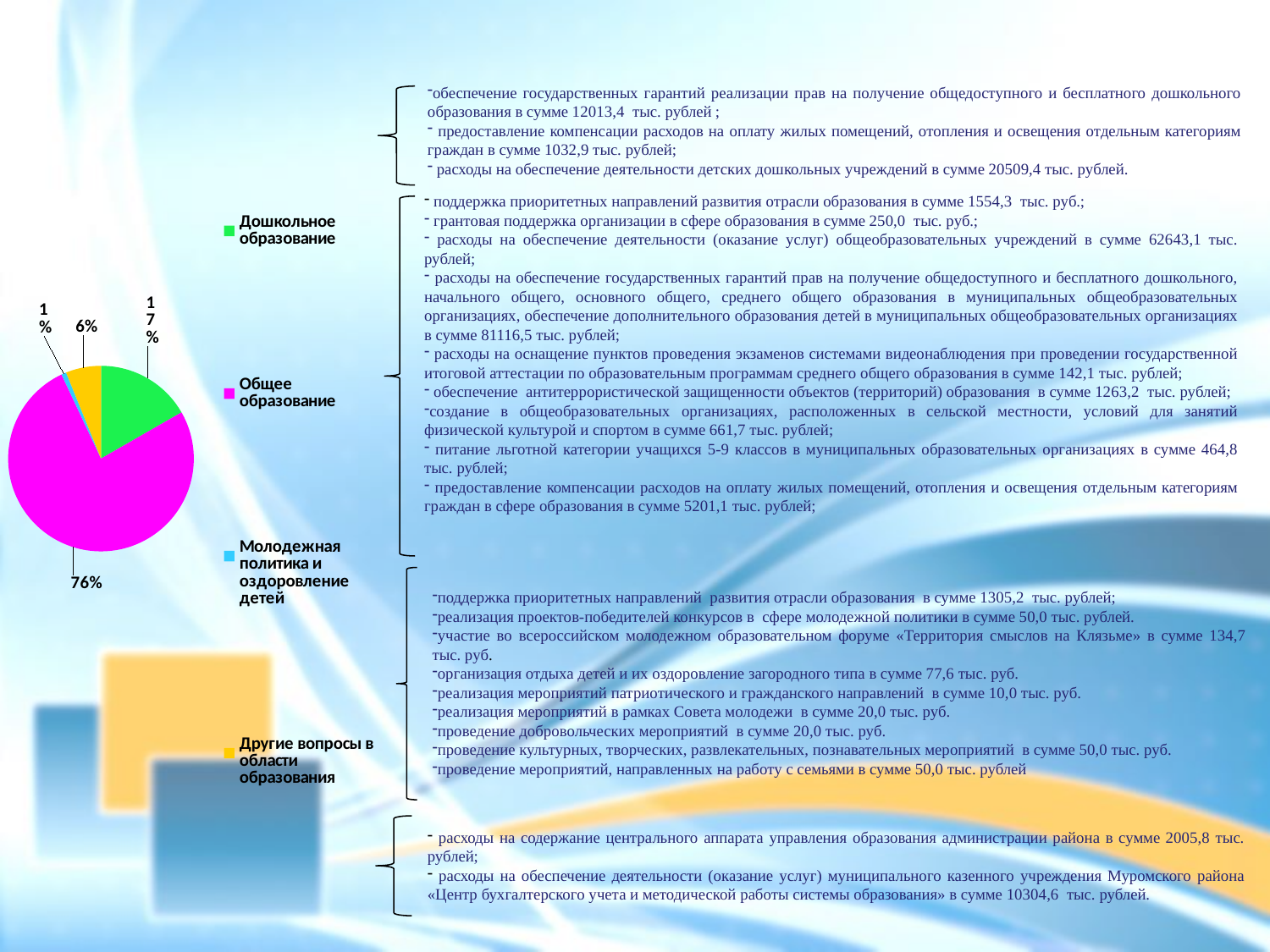
What share of the pie does Молодежная политика и оздоровление детей take? 1% How many entries does the legend of the pie chart list? 4 What share of the pie does Дошкольное образование take? 17% What colour is the slice for Общее образование? magenta What is the difference in percentage points between Общее образование and Дошкольное образование? 59 What share of the pie does Общее образование take? 76% Which category has the smallest slice of the pie? Молодежная политика и оздоровление детей Which category has the largest slice of the pie? Общее образование How many slices does the pie chart have? 4 Which is larger: the share for Дошкольное образование or the share for Другие вопросы в области образования? Дошкольное образование What kind of chart is shown on the slide? pie chart